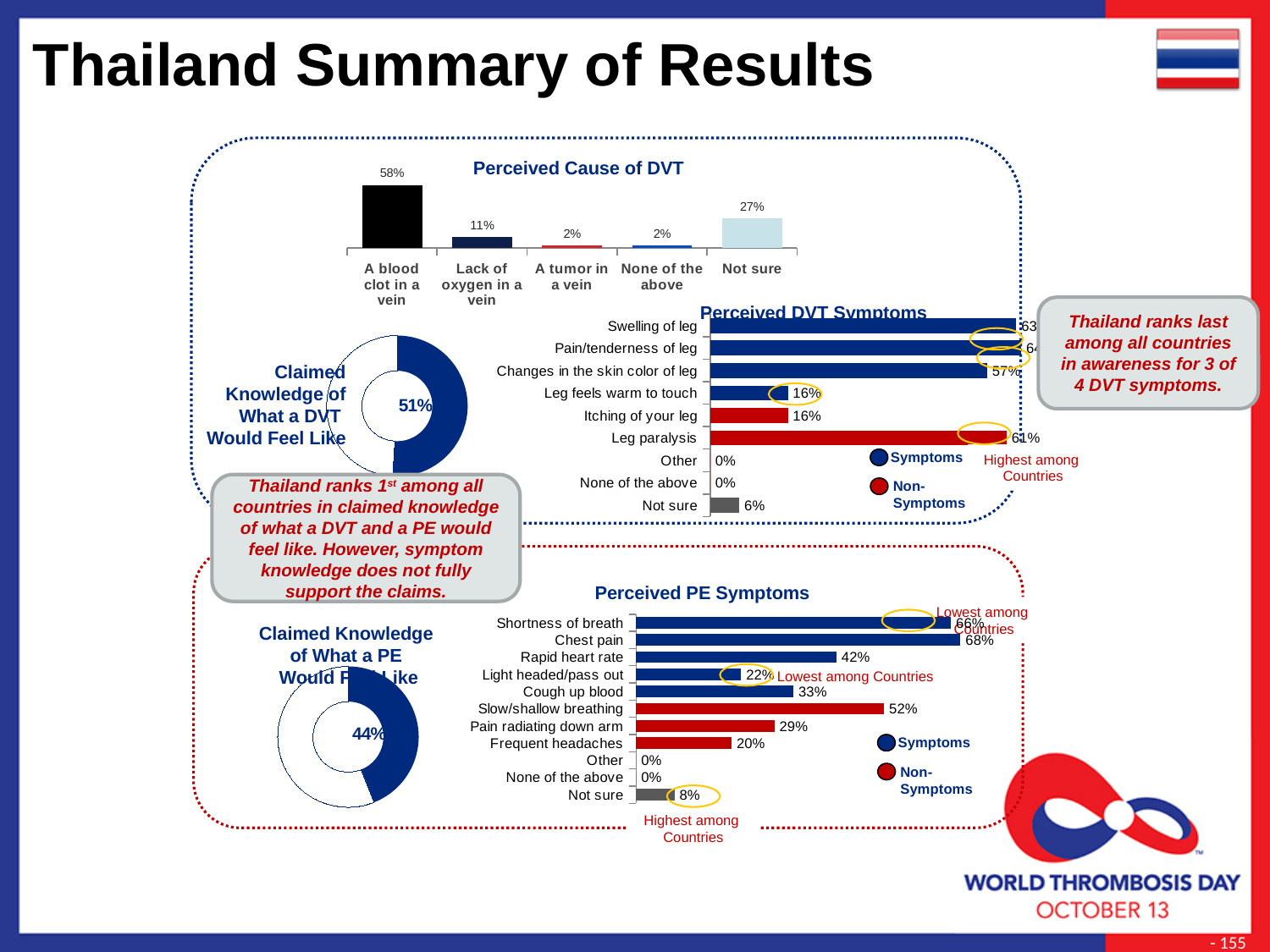
What value is shown in the 'Claimed Knowledge of What a PE Would Feel Like' donut chart? 44% How many series does the legend of the Perceived DVT Symptoms chart list? 2 In the Perceived DVT Symptoms chart, what percentage is shown for 'Leg paralysis'? 61% In the Perceived Cause of DVT chart, what is the difference between 'Not sure' and 'Lack of oxygen in a vein'? 16% What value is shown in the 'Claimed Knowledge of What a DVT Would Feel Like' donut chart? 51% In the Perceived DVT Symptoms chart, what percentage is shown for 'Not sure'? 6% How many categories are shown in the Perceived Cause of DVT chart? 5 In the Perceived Cause of DVT chart, which category has the highest value? A blood clot in a vein What kind of chart is the Perceived PE Symptoms chart? Bar chart In the Perceived Cause of DVT chart, what percentage is shown for 'A blood clot in a vein'? 58% In the Perceived PE Symptoms chart, what percentage is shown for 'Slow/shallow breathing'? 52% In the Perceived PE Symptoms chart, which is larger: 'Rapid heart rate' or 'Cough up blood'? Rapid heart rate